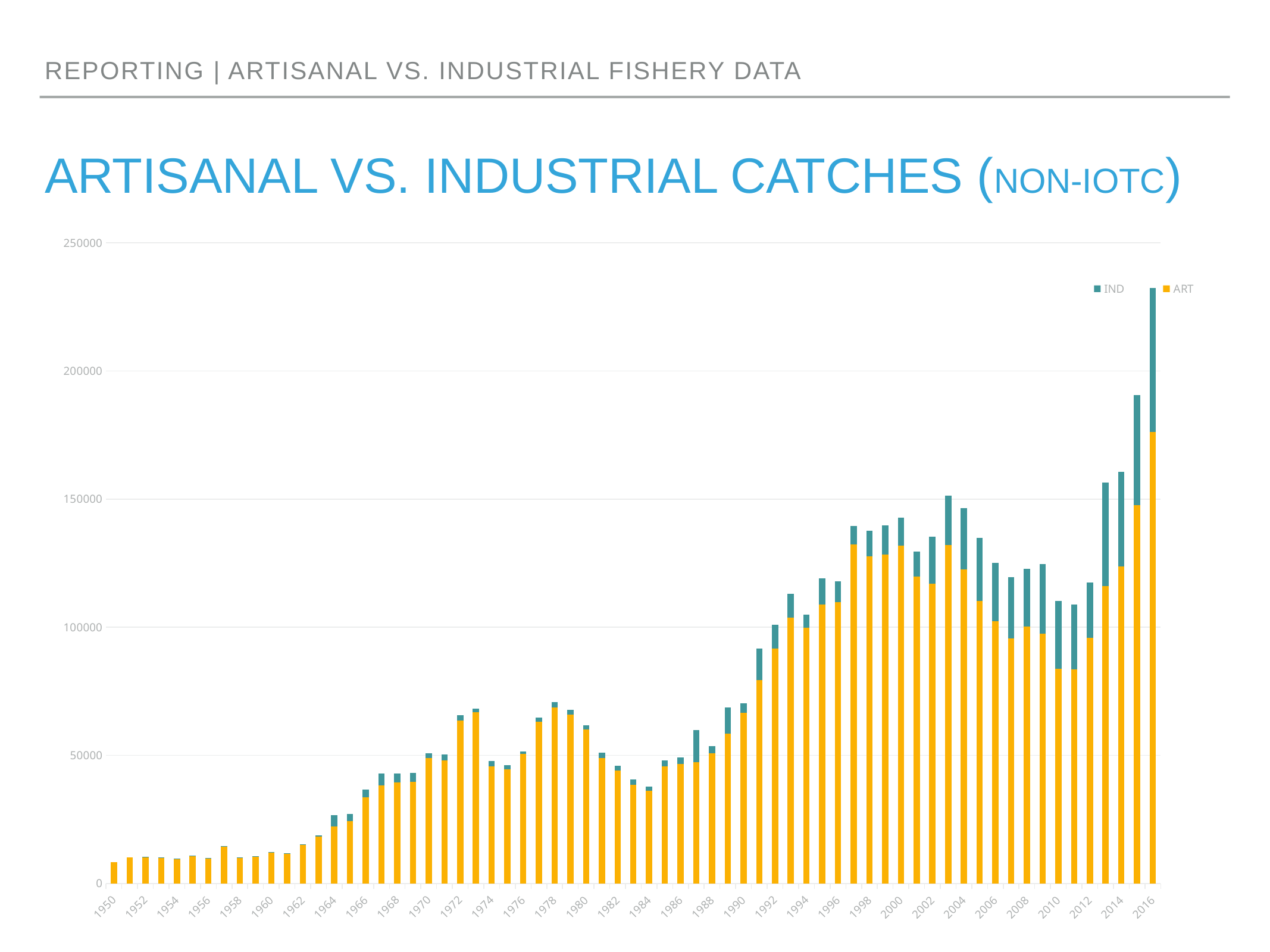
Which year has the larger total catch, 2003 or 2010? 2003 Is the total value for 2015 greater or less than 200000? less Is the total value for 2000 greater or less than 150000? less How many series does the legend list? 2 Overall, do the total catches rise or fall from 1950 to 2016? Rise What kind of chart is shown on the slide? Stacked bar chart Which year has the highest total catch? 2016 Which year has the lowest total catch? 1950 Which year has the larger total catch, 1972 or 1984? 1972 What are the two series named in the legend? IND and ART Is the total value for 1950 greater or less than 50000? less